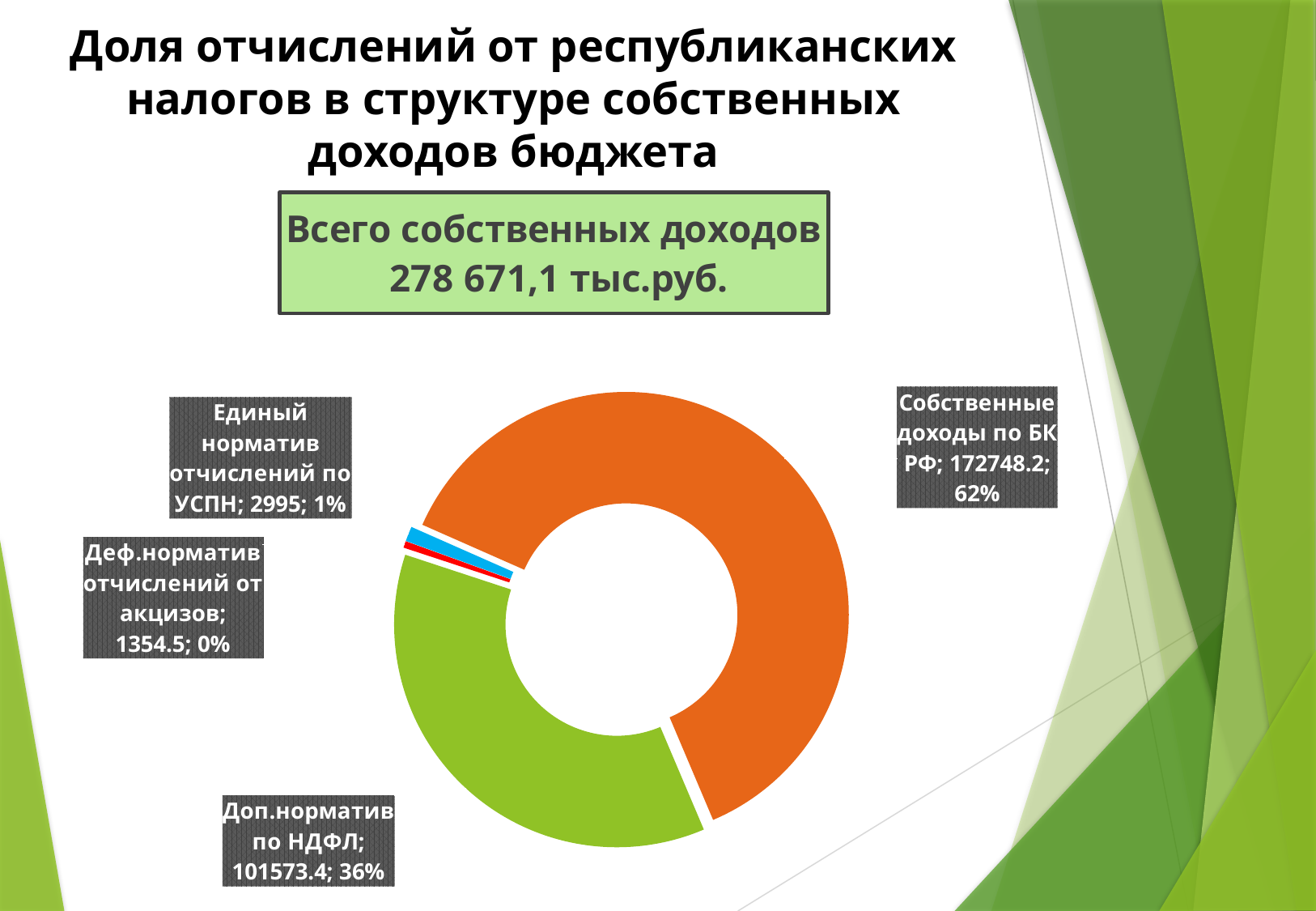
What is the value for Доп.норматив по НДФЛ? 101573.4 What is the value for Деф.норматив отчислений от акцизов? 1354.5 What is the value for Единый норматив отчислений по УСПН? 2995 What is the difference between the values for Собственные доходы по БК РФ and Доп.норматив по НДФЛ? 71174.8 What is the value for Собственные доходы по БК РФ? 172748.2 What share of the chart does Собственные доходы по БК РФ represent? 62% Which is larger, the value for Единый норматив отчислений по УСПН or Деф.норматив отчислений от акцизов? Единый норматив отчислений по УСПН How many slices does the chart have? 4 Which category has the smallest slice? Деф.норматив отчислений от акцизов What kind of chart is shown on the slide? doughnut chart What share of the chart does Доп.норматив по НДФЛ represent? 36% Which category has the largest slice? Собственные доходы по БК РФ